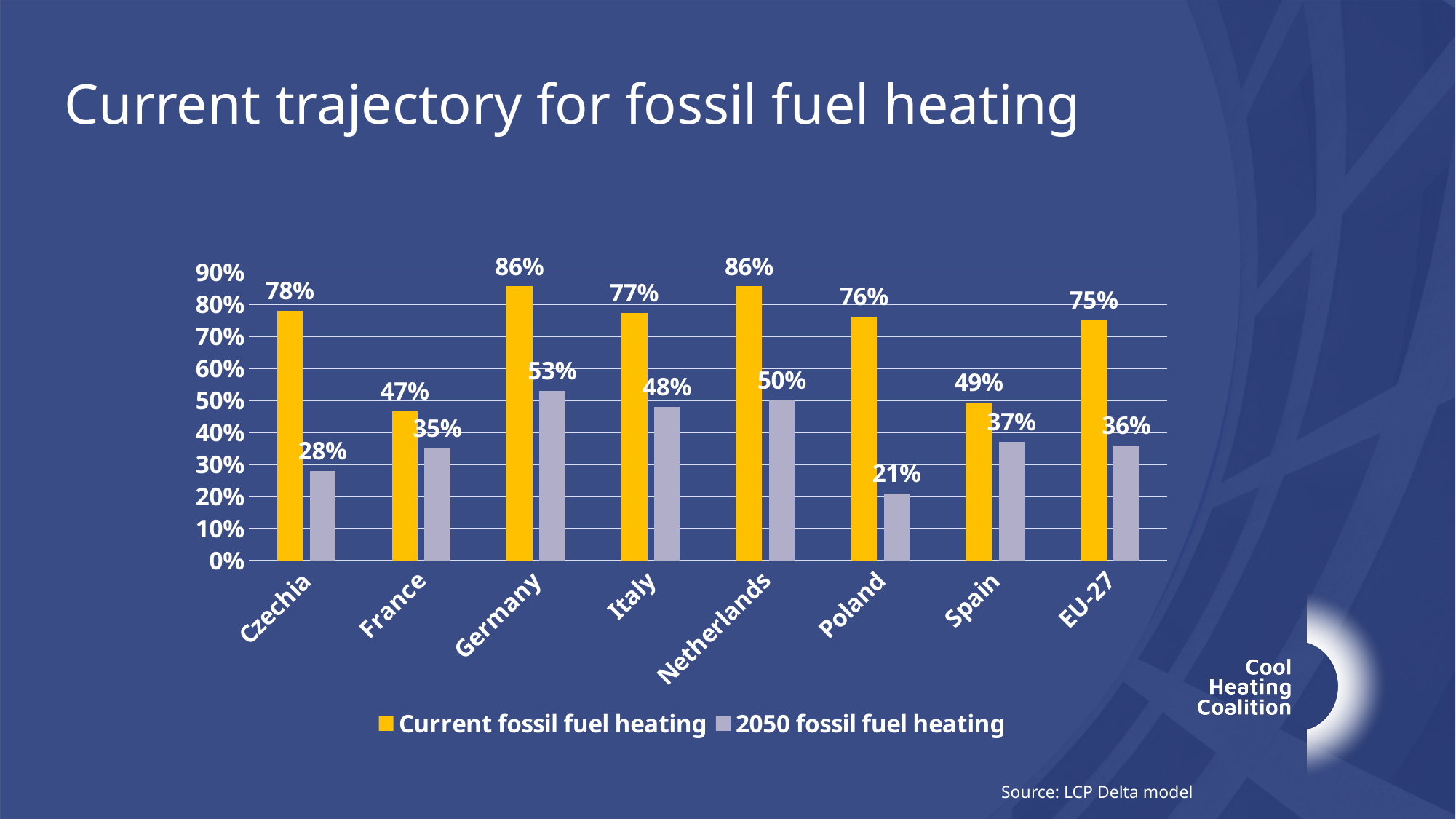
What is the difference between the current and 2050 fossil fuel heating values for Spain? 12% What is the current fossil fuel heating value for Czechia? 78% What kind of chart is shown on the slide? Bar chart What is the 2050 fossil fuel heating value for Poland? 21% What is the difference between the current and 2050 fossil fuel heating values for Poland? 55% Which country has the lowest current fossil fuel heating value? France How many countries or regions are shown on the x axis? 8 What is the 2050 fossil fuel heating value for EU-27? 36% Which category has the lowest 2050 fossil fuel heating value? Poland How many series does the legend list? 2 Which is larger: the 2050 fossil fuel heating value for Italy or for France? Italy Which category has the highest 2050 fossil fuel heating value? Germany